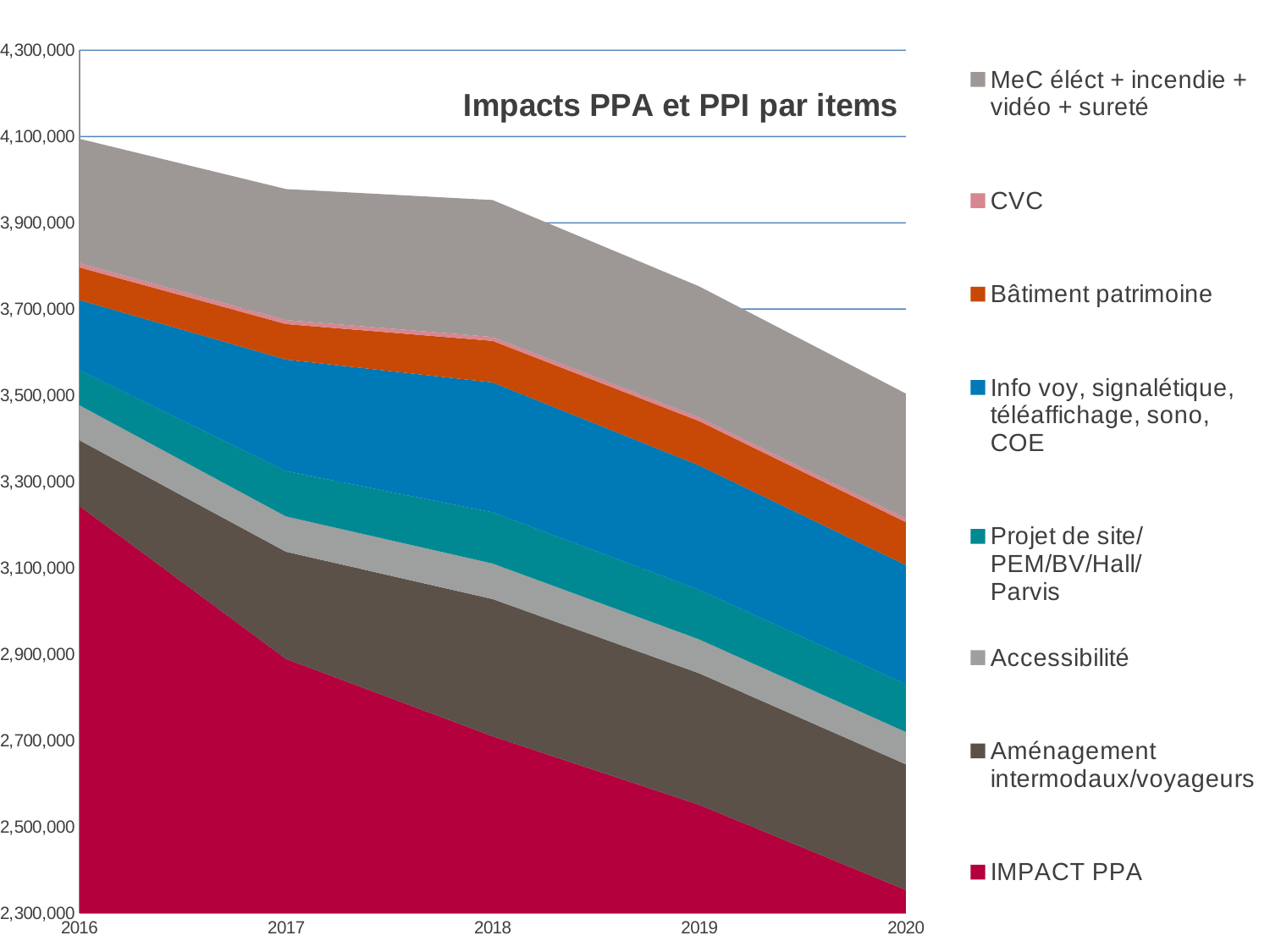
Is the total stacked value in 2018 greater or less than 3,900,000? greater What kind of chart is shown on the slide? Stacked area chart How many years are shown along the x axis? 5 Which series contributes the smallest share of the stacked total? CVC How many series does the legend list? 8 Does the total stacked value rise or fall from 2016 to 2020? Fall What is the title of the chart? Impacts PPA et PPI par items Is the value for IMPACT PPA larger in 2016 or in 2020? 2016 Which series contributes the largest share of the stacked total? IMPACT PPA Is the total stacked value in 2019 greater or less than 3,700,000? greater Is the value for IMPACT PPA in 2016 greater or less than 3,300,000? less